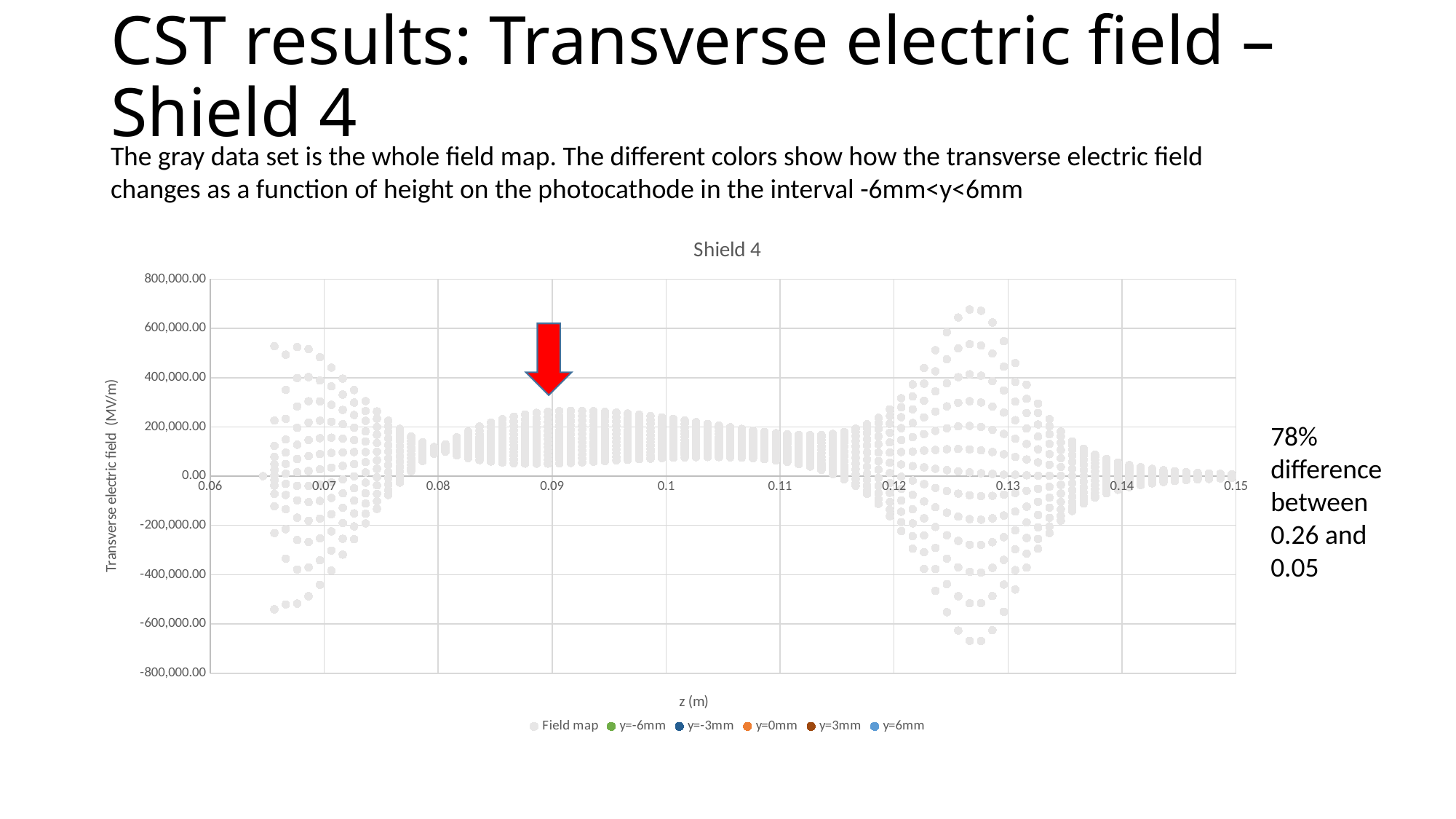
Is the highest Field map value near z = 0.145 greater or less than 200,000.00? less Is the highest Field map value near z = 0.09 greater or less than 400,000.00? less What is the title of the chart? Shield 4 What kind of chart is shown on the slide? scatter chart Is the lowest Field map value near z = 0.13 greater or less than -600,000.00? less Which series in the legend is plotted in gray? Field map What is the label of the x axis of the chart? z (m) How many series does the legend of the Shield 4 chart list? 6